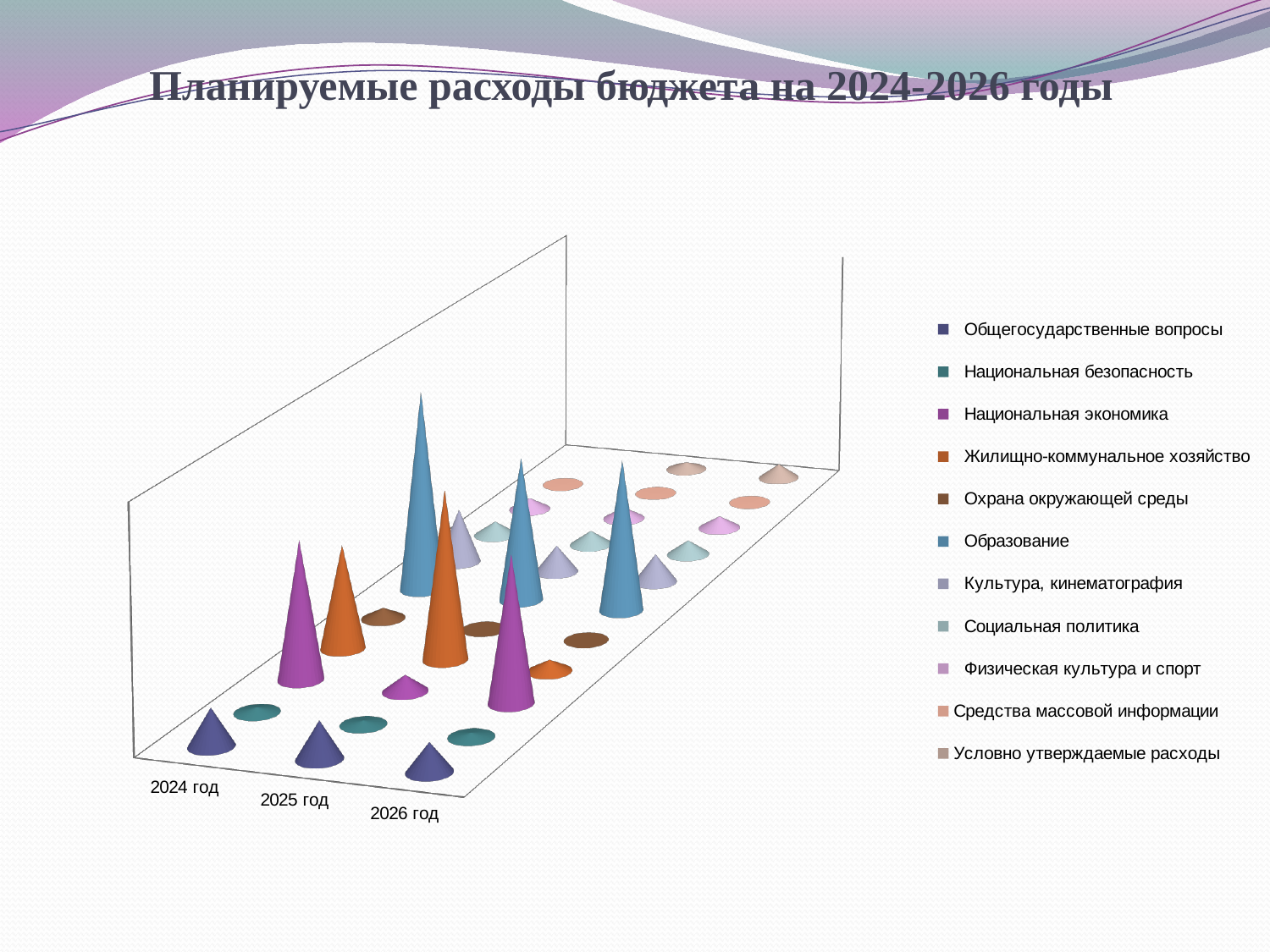
Which series has the tallest cone for 2025 год? Жилищно-коммунальное хозяйство For 2024 год, which is larger: Жилищно-коммунальное хозяйство or Охрана окружающей среды? Жилищно-коммунальное хозяйство Which series has the tallest cone for 2026 год? Образование Which series has the tallest cone for 2024 год? Образование For 2024 год, which is larger: Национальная экономика or Общегосударственные вопросы? Национальная экономика How many series does the chart's legend list? 11 For 2026 год, which is larger: Образование or Национальная безопасность? Образование What is the title of the slide's chart? Планируемые расходы бюджета на 2024-2026 годы How many year categories are shown along the x axis of the chart? 3 What kind of chart is shown on the slide? bar chart Which years are shown as categories on the chart? 2024 год, 2025 год, 2026 год